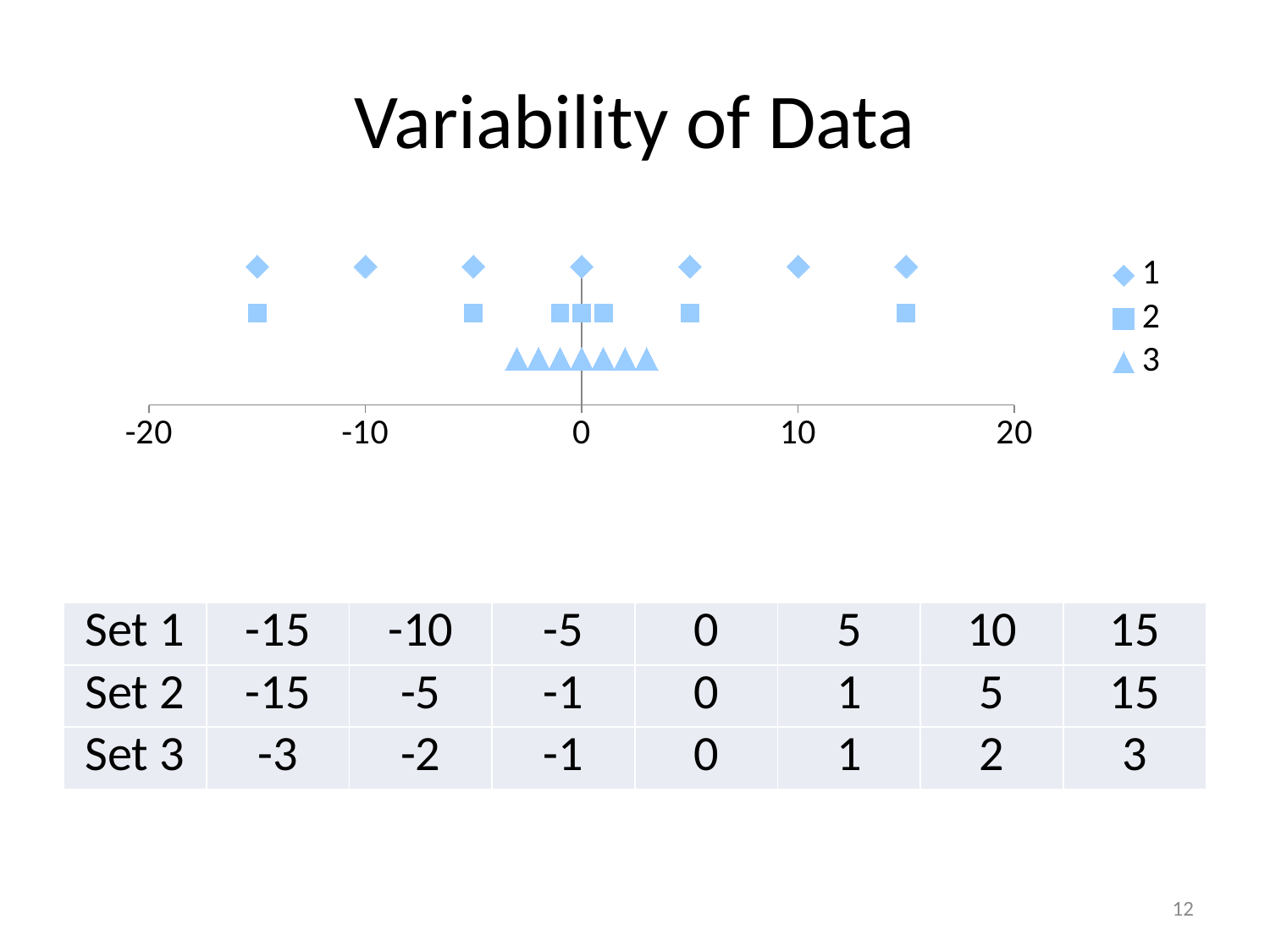
Is the leftmost point of series 1 greater or less than -10? less How many series does the chart legend list? 3 What is the difference between the largest and smallest values in Set 1? 30 How many points are plotted in total across all three series? 21 What marker shape is used for series 3? triangles Is the rightmost point of series 3 greater or less than 10? less What is the smallest value in Set 2? -15 What is the smallest value in Set 3? -3 What kind of chart is shown on the slide? scatter chart What is the largest value in Set 1? 15 How many points are plotted for series 1? 7